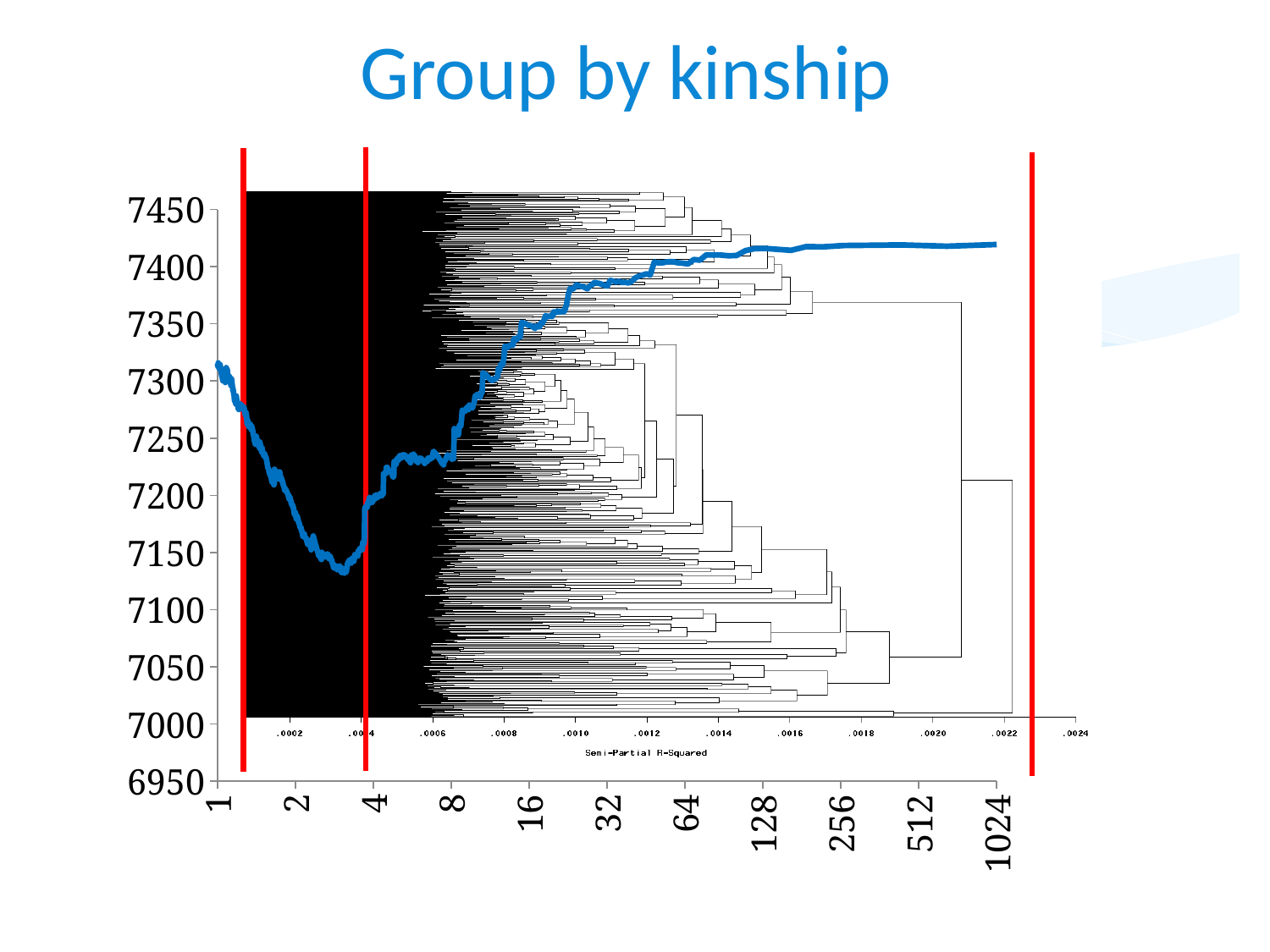
Is the value of the blue line at x = 8 greater or less than 7200? greater What is the highest value labelled on the y axis? 7450 Between which two x-axis tick labels does the blue line reach its lowest point? 2 and 4 Is the value of the blue line at x = 32 greater or less than 7350? greater What is the title of the slide's chart? Group by kinship Which is larger, the value of the blue line at x = 1 or at x = 1024? x = 1024 Does the blue line rise or fall between x = 8 and x = 128? rise Is the lowest point of the blue line greater or less than 7150? less How many tick labels are shown on the x axis (1 through 1024)? 11 What kind of chart is the blue series plotted as? line chart